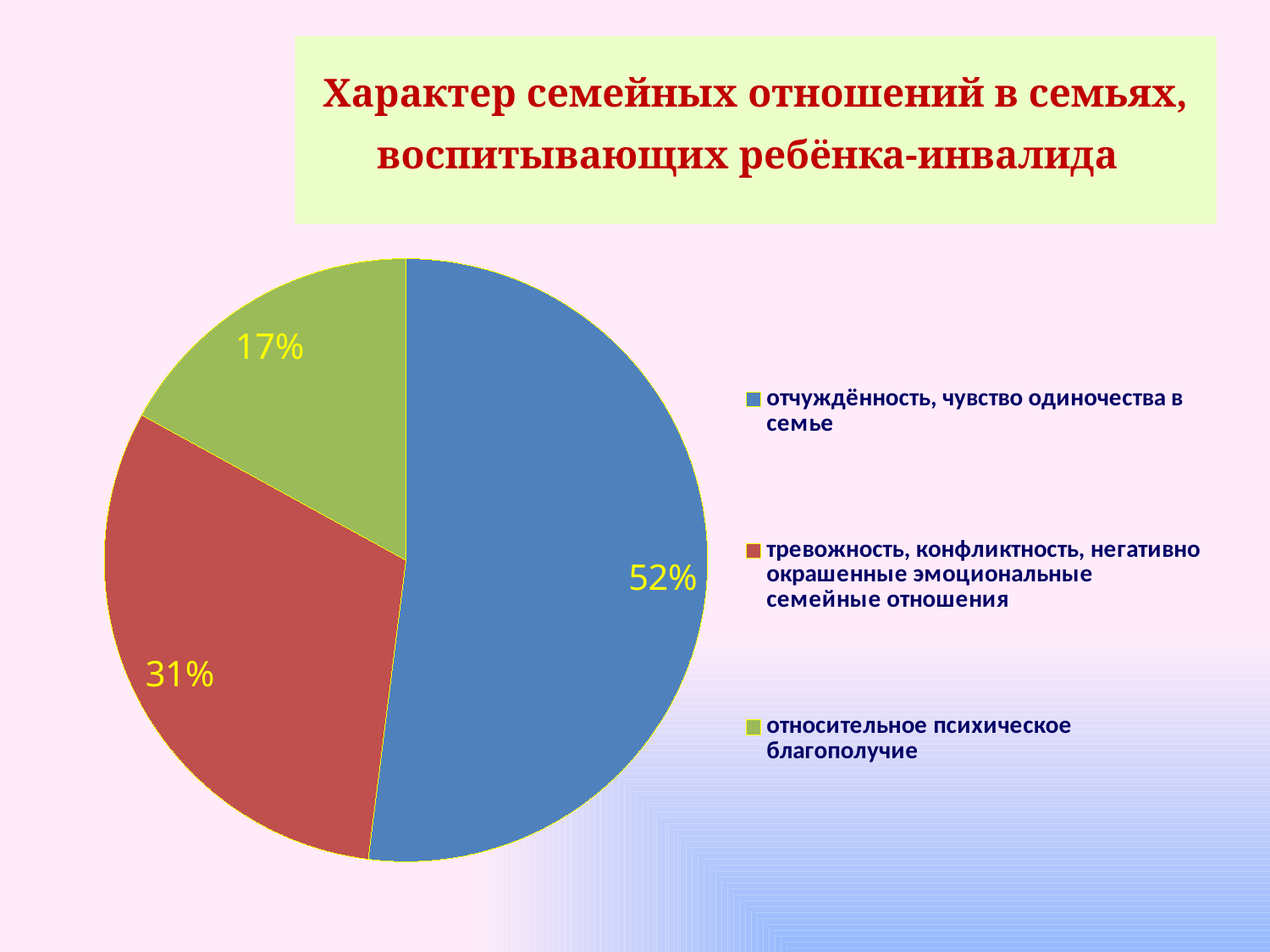
What share of the pie is labelled "относительное психическое благополучие"? 17% Which is larger: the slice for "тревожность, конфликтность, негативно окрашенные эмоциональные семейные отношения" or the slice for "относительное психическое благополучие"? тревожность, конфликтность, негативно окрашенные эмоциональные семейные отношения Which category has the largest slice of the pie? отчуждённость, чувство одиночества в семье What is the title of the slide containing the pie chart? Характер семейных отношений в семьях, воспитывающих ребёнка-инвалида What colour is the slice for "относительное психическое благополучие"? green Which category has the smallest slice of the pie? относительное психическое благополучие What is the difference in percentage points between the slice for "тревожность, конфликтность, негативно окрашенные эмоциональные семейные отношения" and the slice for "относительное психическое благополучие"? 14% What kind of chart is shown on the slide? pie chart What share of the pie is labelled "отчуждённость, чувство одиночества в семье"? 52% What share of the pie is labelled "тревожность, конфликтность, негативно окрашенные эмоциональные семейные отношения"? 31% What is the difference in percentage points between the slice for "отчуждённость, чувство одиночества в семье" and the slice for "тревожность, конфликтность, негативно окрашенные эмоциональные семейные отношения"? 21% How many slices does the pie chart have? 3